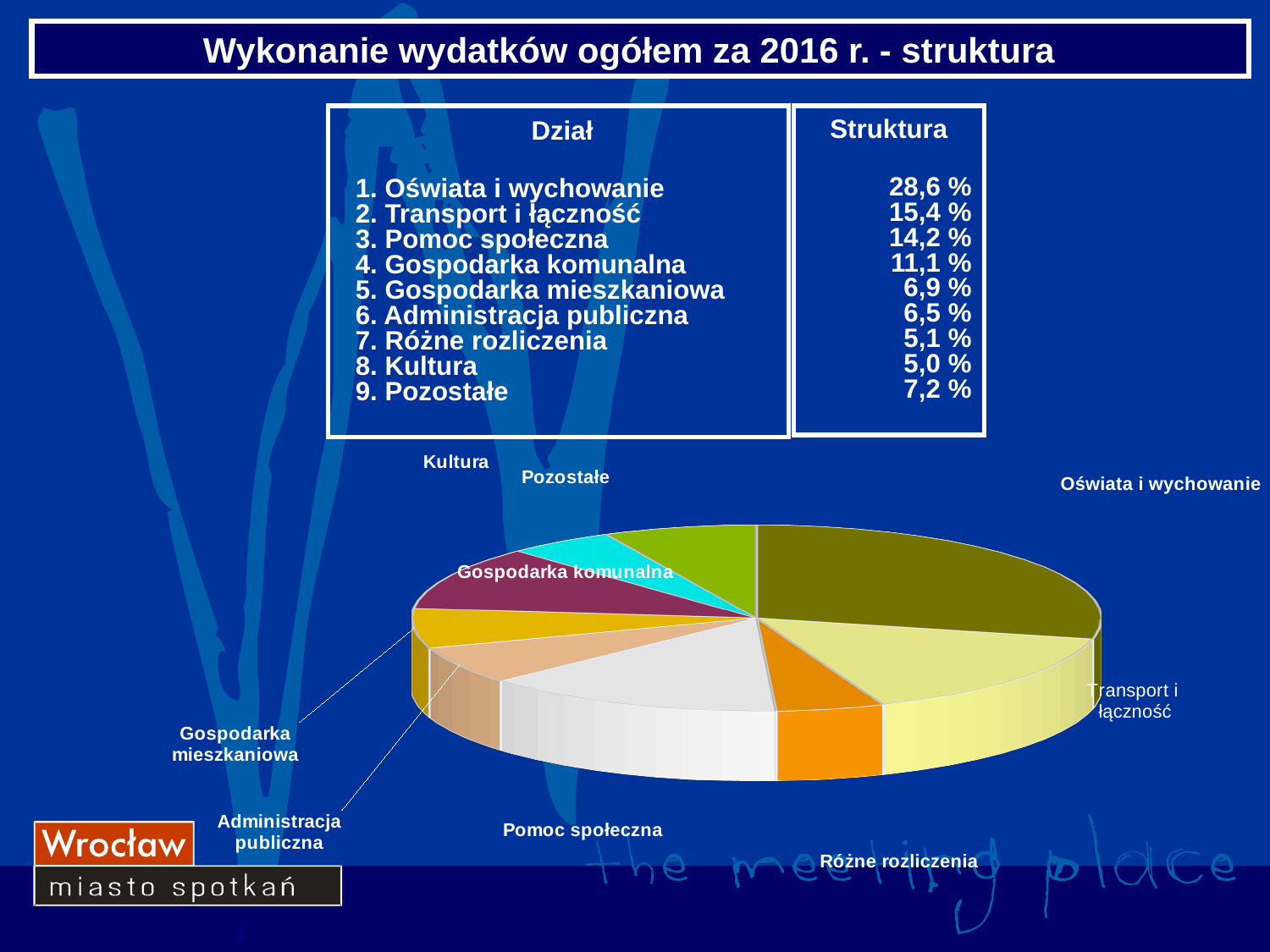
What is the difference between the shares of Oświata i wychowanie and Transport i łączność? 13,2 % How many slices does the pie chart have? 9 Which category has the largest share of the pie? Oświata i wychowanie What kind of chart is shown on the slide? pie chart What is the title of the slide containing the pie chart? Wykonanie wydatków ogółem za 2016 r. - struktura What is the share for Administracja publiczna? 6,5 % What is the share for Gospodarka komunalna? 11,1 % What is the share for Oświata i wychowanie? 28,6 % What is the share for Pozostałe? 7,2 % Which has a larger share, Pomoc społeczna or Gospodarka komunalna? Pomoc społeczna What is the share for Transport i łączność? 15,4 % What is the share for Pomoc społeczna? 14,2 %